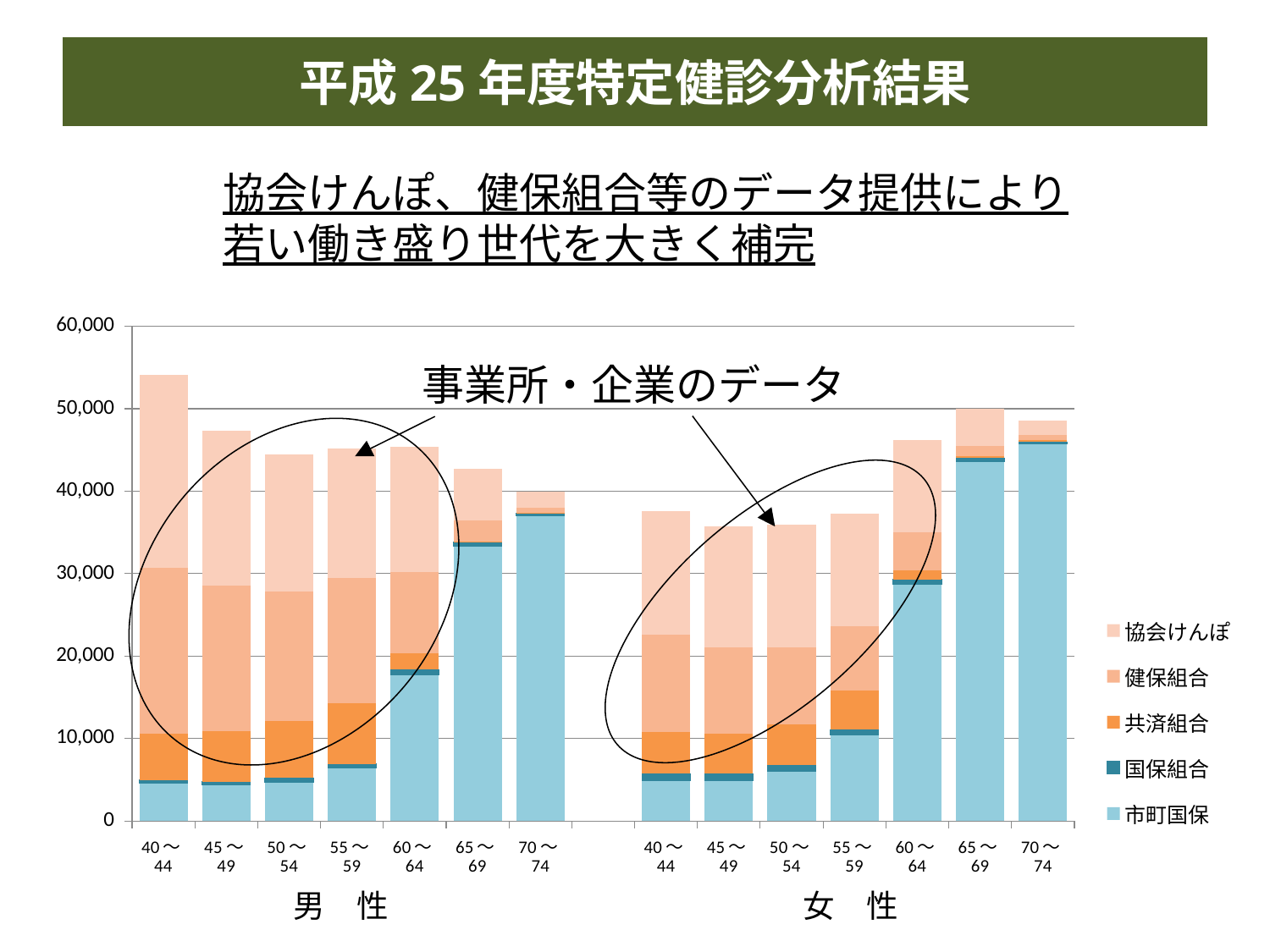
Is the total for 男性 65～69 greater or less than 40,000? greater What text is written in the annotation pointing to the circled parts of the bars? 事業所・企業のデータ How many series does the legend list? 5 Does the 市町国保 segment for 男性 rise or fall as the age group increases from 40～44 to 70～74? rise What kind of chart is shown on the slide? Stacked bar chart How many bars (age-group categories) are plotted in total across 男性 and 女性? 14 Which is larger, the total for 男性 40～44 or the total for 女性 40～44? 男性 40～44 Is the total for 男性 40～44 greater or less than 50,000? greater Which series is plotted at the bottom of each stacked bar? 市町国保 Which bar has the highest total? 男性 40～44 Which is larger, the total for 女性 65～69 or the total for 女性 40～44? 女性 65～69 Is the total for 女性 40～44 greater or less than 40,000? less